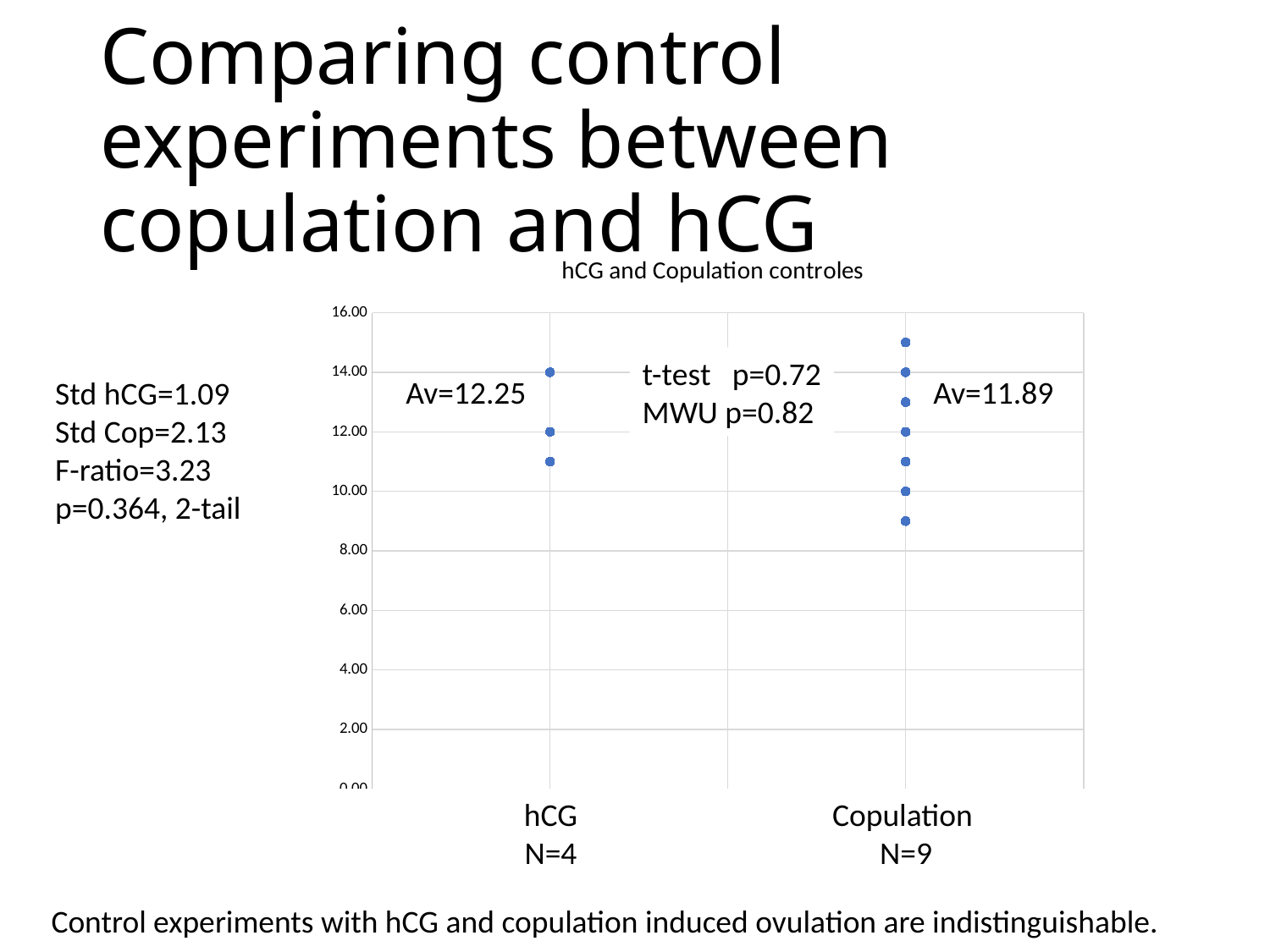
What is the sample size (N) shown for the Copulation group? N=9 Is the lowest plotted point in the Copulation group greater or less than 10.00? less What kind of chart is shown on the slide? scatter chart What is the sample size (N) shown for the hCG group? N=4 Which group has the higher annotated average, hCG or Copulation? hCG What is the value of the highest plotted point in the hCG group? 14.00 What is the difference between the annotated averages of the hCG and Copulation groups? 0.36 Is the highest plotted point in the Copulation group greater or less than 14.00? greater What is the title of the chart? hCG and Copulation controles What is the average value (Av) annotated for the hCG group? Av=12.25 What is the average value (Av) annotated for the Copulation group? Av=11.89 How many categories are shown on the x axis of the chart? 2